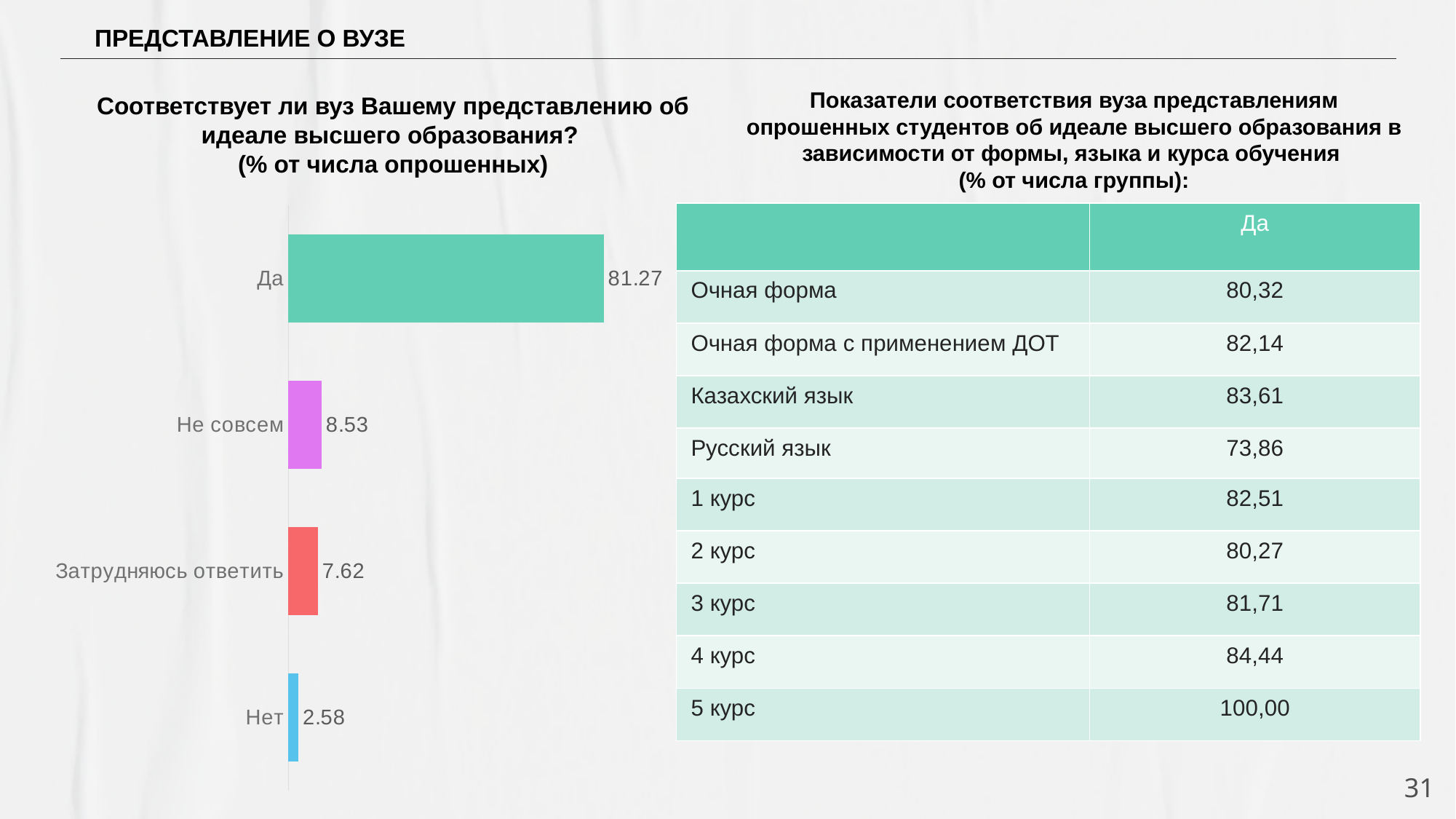
How many categories are shown in the bar chart? 4 Which category has the highest value in the bar chart? Да In the bar chart, which is larger: the value for "Не совсем" or the value for "Нет"? Не совсем In the bar chart, what is the value for "Да"? 81.27 In the bar chart, what is the difference between the values for "Да" and "Нет"? 78.69 In the bar chart, what is the value for "Не совсем"? 8.53 In the bar chart, what is the value for "Нет"? 2.58 Which category has the lowest value in the bar chart? Нет In the bar chart, what is the value for "Затрудняюсь ответить"? 7.62 What type of chart is shown on the left of the slide? Bar chart What colour is the bar for "Да" in the bar chart? Green In the bar chart, what is the difference between the values for "Не совсем" and "Затрудняюсь ответить"? 0.91